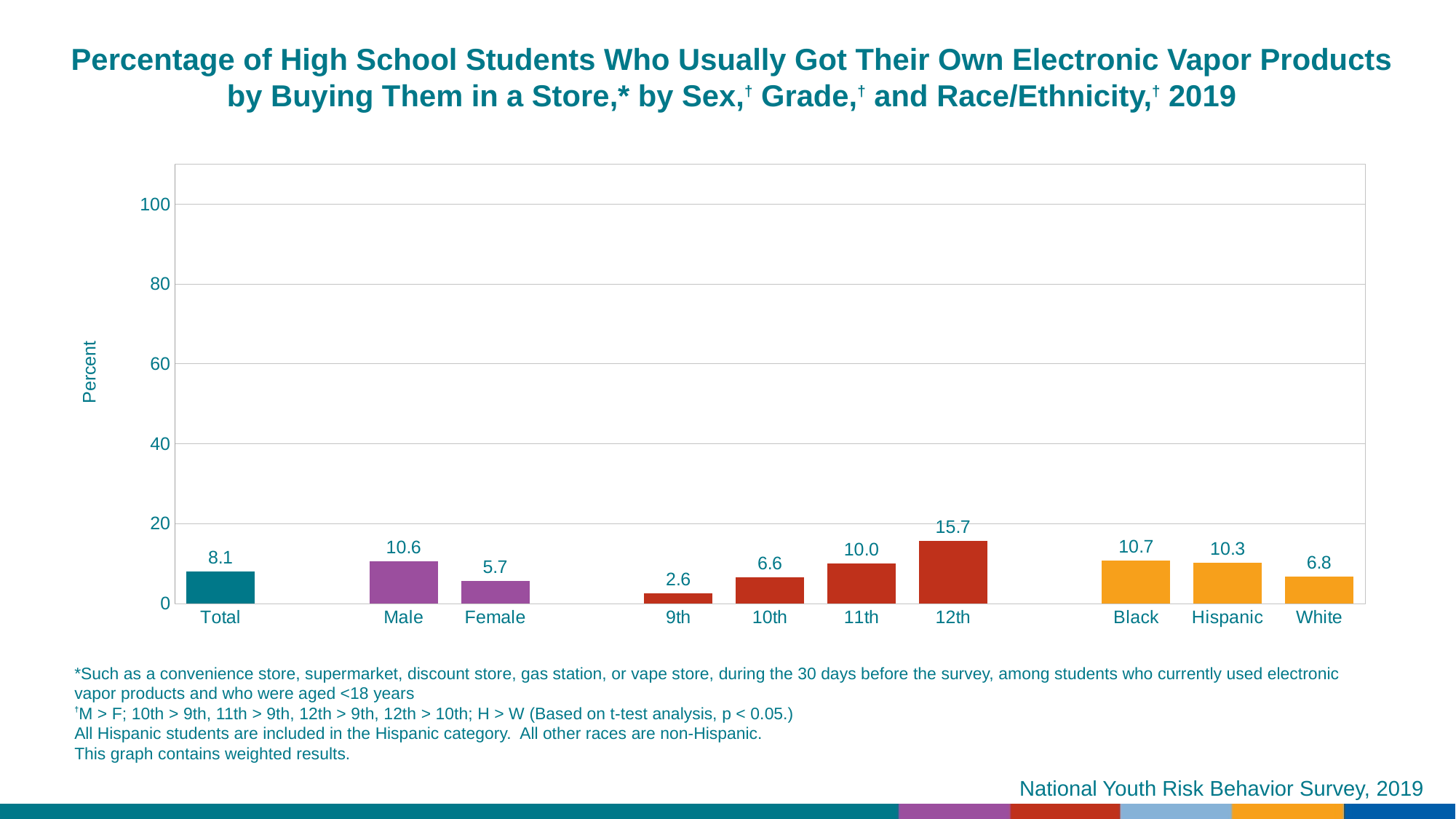
How many categories are shown on the x axis? 10 Is the value for 12th grade greater or less than 20? less What is the value for Male? 10.6 Which category has the highest value? 12th What kind of chart is this? bar chart Do the values rise or fall from 9th grade to 12th grade? rise What is the value for Hispanic students? 10.3 What is the difference between the values for Male and Female? 4.9 Which category has the lowest value? 9th Which is larger, the value for Black or the value for White? Black What is the value for 9th grade? 2.6 What is the value for Total? 8.1